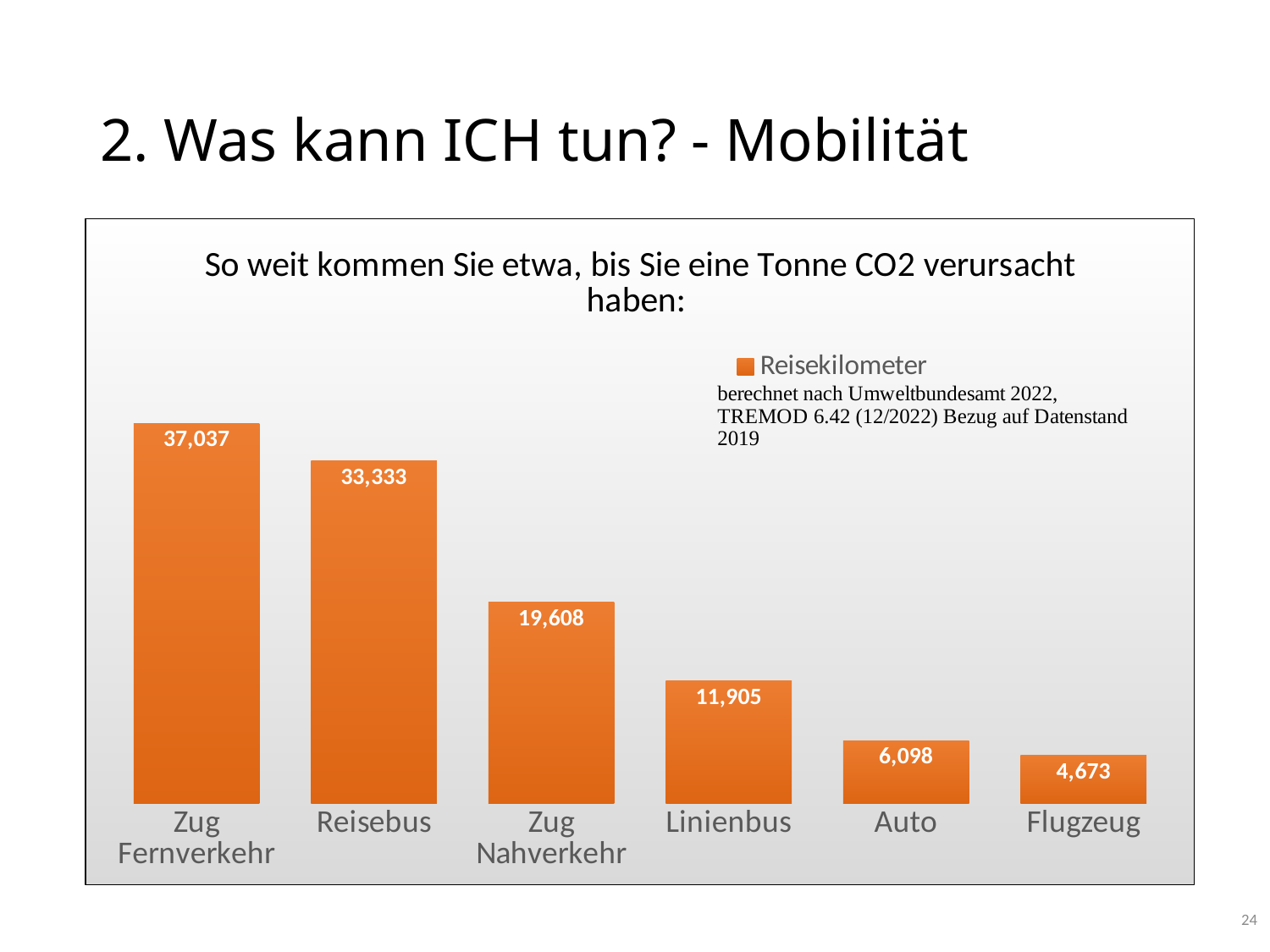
Which category has the lowest value? Flugzeug Which is larger, the value for Zug Nahverkehr or the value for Linienbus? Zug Nahverkehr What is the value for Flugzeug? 4,673 Which category has the highest value? Zug Fernverkehr What is the value for Reisebus? 33,333 What series name does the legend show? Reisekilometer How many categories are shown in the chart? 6 What is the difference between the values for Auto and Flugzeug? 1,425 What is the value for Linienbus? 11,905 What is the difference between the values for Zug Fernverkehr and Reisebus? 3,704 What is the value for Zug Fernverkehr? 37,037 What kind of chart is shown on the slide? Bar chart